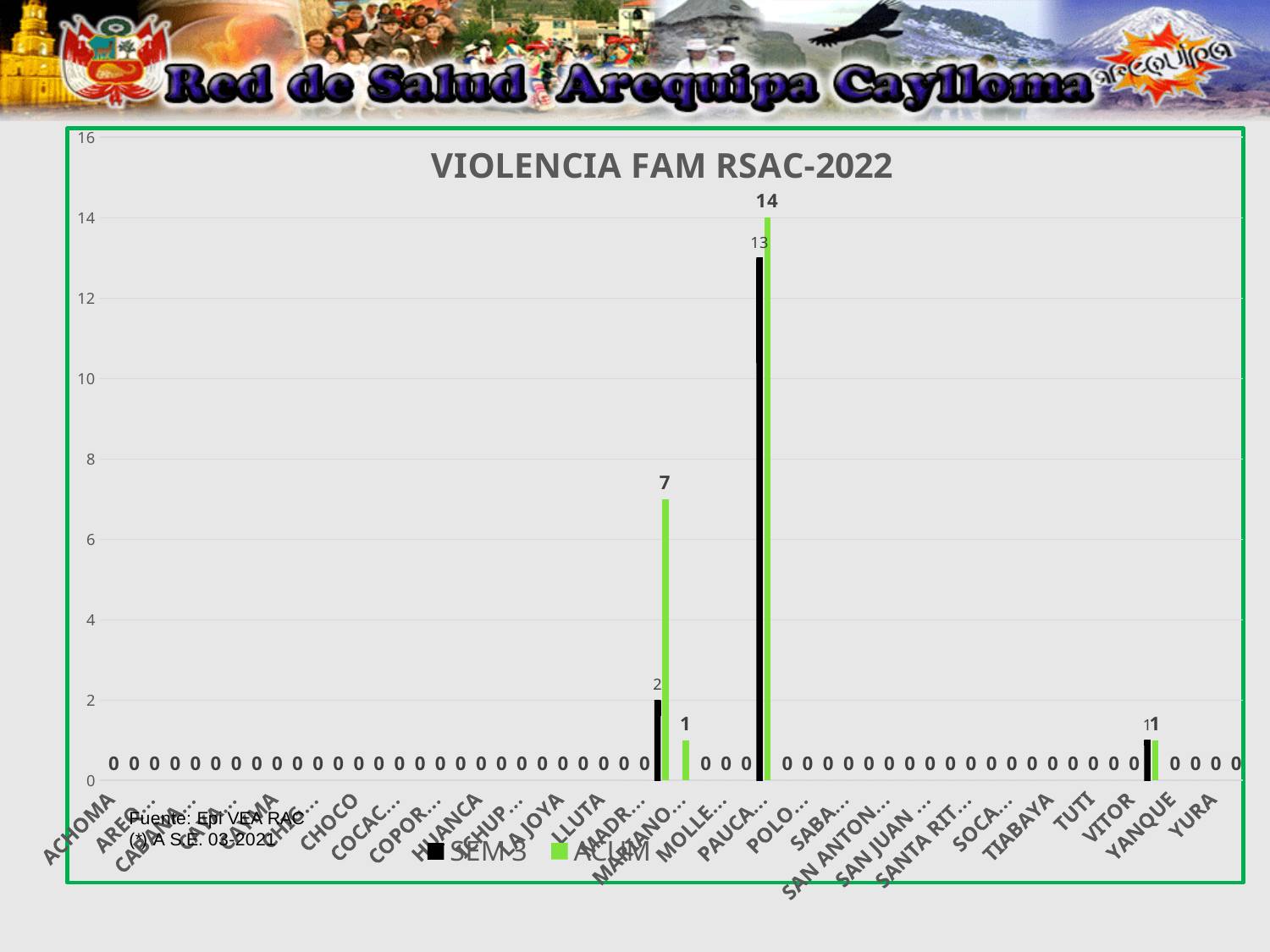
What is the second-highest value shown for the ACUM series? 7 What is the ACUM value for ACHOMA? 0 How many series does the legend list? 2 What is the difference between the highest ACUM value and the highest SEM 3 value? 1 What is the title of the chart? VIOLENCIA FAM RSAC-2022 What kind of chart is shown on the slide? bar chart Which colour represents the ACUM series? green At the tallest pair of bars, which series has the larger value, SEM 3 or ACUM? ACUM What is the highest value shown for the SEM 3 series? 13 What is the highest value shown for the ACUM series? 14 Is the highest value in the chart greater or less than 12? greater